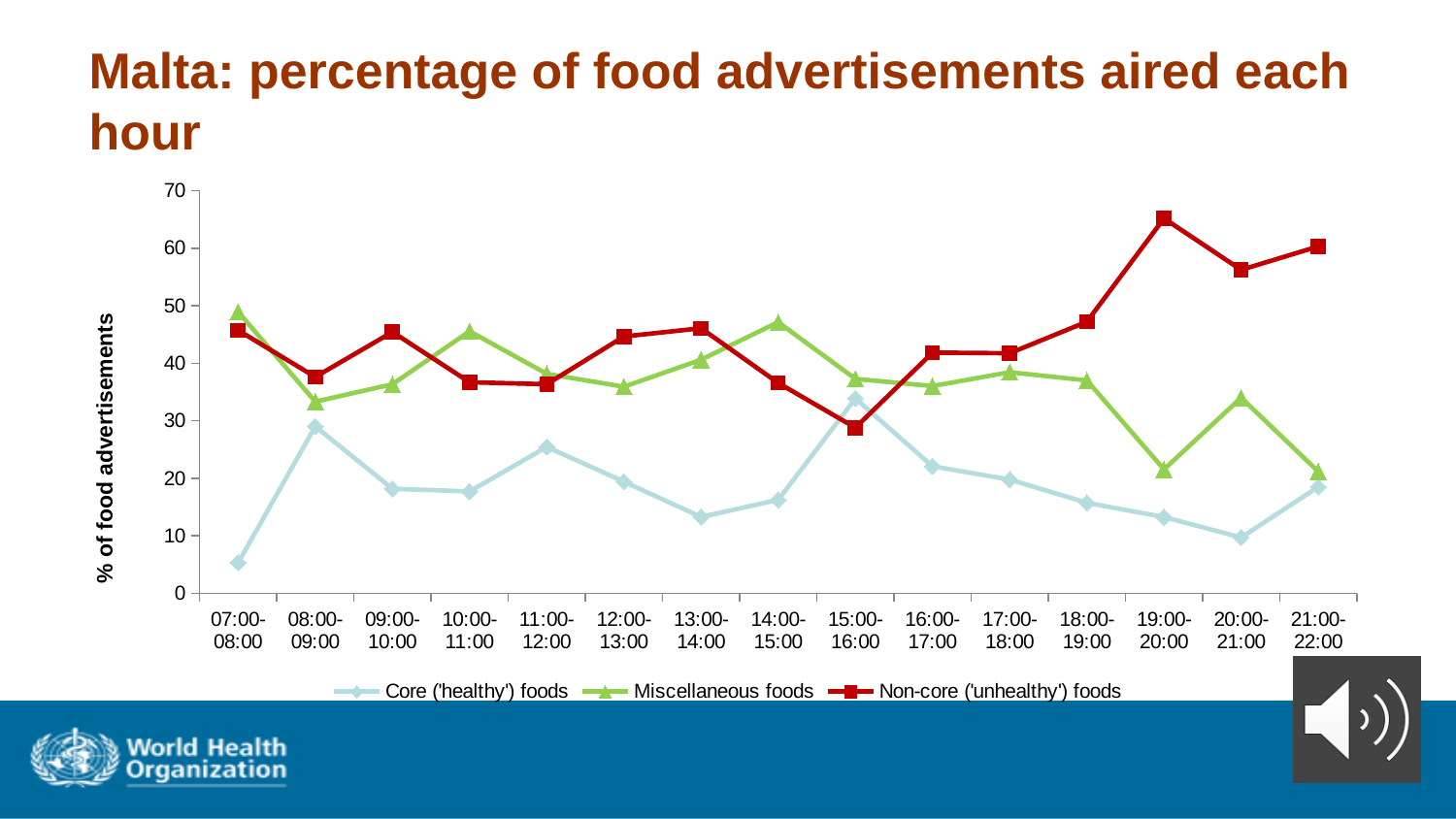
Is the value for Core ('healthy') foods at 07:00-08:00 greater or less than 10? less In which hour is the value for Core ('healthy') foods lowest? 07:00-08:00 Does the value for Non-core ('unhealthy') foods rise or fall from 18:00-19:00 to 19:00-20:00? Rise At 21:00-22:00, which is larger: Non-core ('unhealthy') foods or Core ('healthy') foods? Non-core ('unhealthy') foods What is the title of the y axis? % of food advertisements How many hourly time slots are plotted along the x axis? 15 How many series does the legend list? 3 In which hour is the value for Core ('healthy') foods highest? 15:00-16:00 In which hour is the value for Non-core ('unhealthy') foods highest? 19:00-20:00 What kind of chart is shown on the slide? Line chart Is the value for Non-core ('unhealthy') foods at 19:00-20:00 greater or less than 60? greater At 07:00-08:00, which is larger: Miscellaneous foods or Core ('healthy') foods? Miscellaneous foods